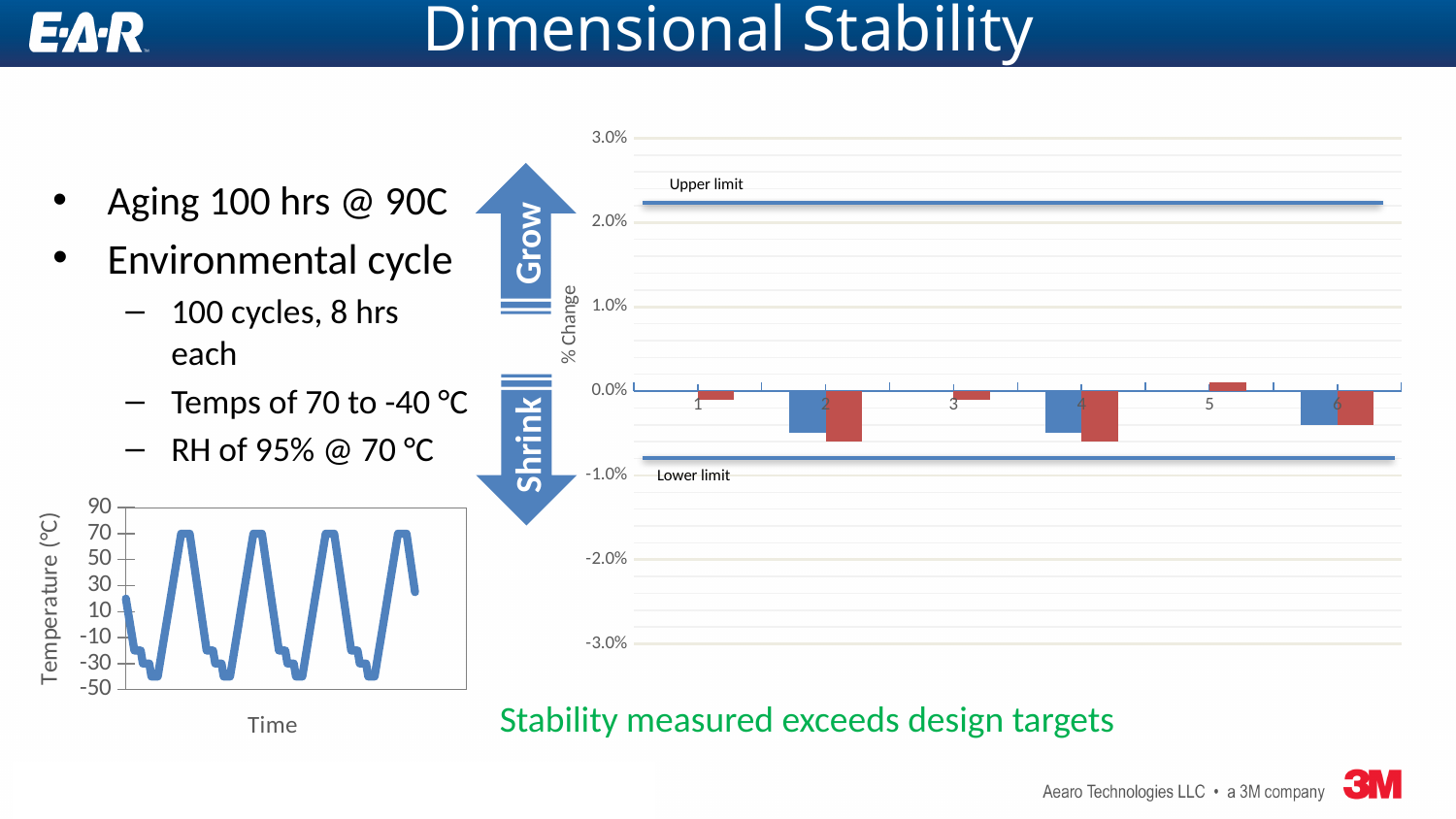
What kind of chart is the chart at the bottom left showing Temperature versus Time? line chart In the % Change bar chart, is the Upper limit line greater or less than 2.0%? greater In the % Change bar chart, is the red bar for category 2 greater or less than 0.0%? less In the Temperature versus Time line chart, what is the highest value shown on the y axis? 90 In the % Change bar chart, how many numbered categories are shown on the x axis? 6 In the % Change bar chart, is the Lower limit line greater or less than -1.0%? greater In the Temperature versus Time line chart, what temperature do the peaks of the line reach? 70 In the % Change bar chart, which is larger, the red bar for category 1 or the red bar for category 2? category 1 What kind of chart is the chart on the right showing % Change? bar chart